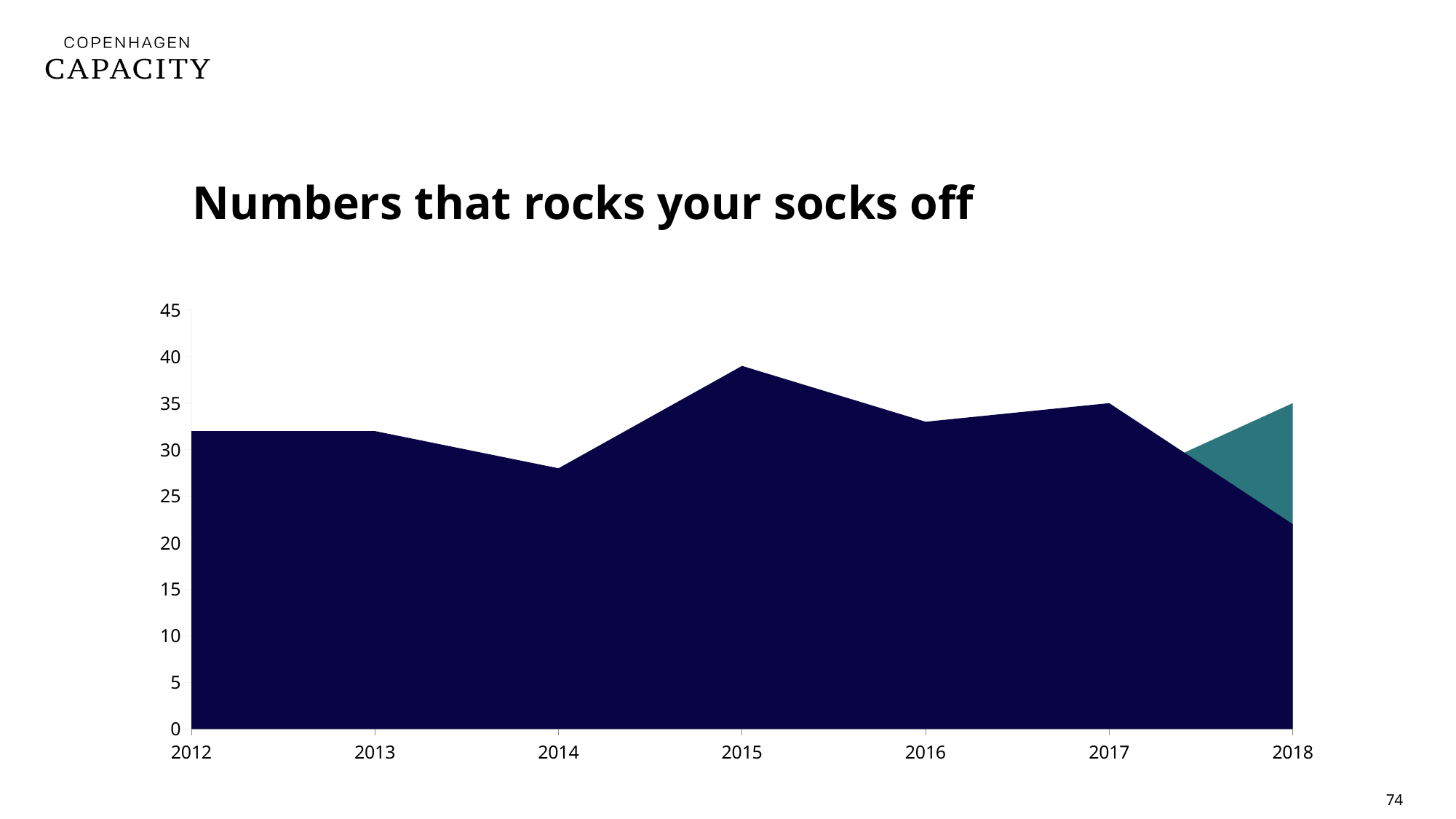
How many years are shown along the x axis of the chart? 7 Does the value rise or fall from 2014 to 2015? rise Does the dark navy area rise or fall from 2017 to 2018? fall Which is larger, the value for 2014 or the value for 2015? 2015 What kind of chart is shown on the slide? area chart Is the value for 2012 greater or less than 30? greater Which year has the highest value in the chart? 2015 Is the value of the dark navy area for 2018 greater or less than 25? less Which year has the lowest value for the dark navy area? 2018 What is the title of the chart on the slide? Numbers that rocks your socks off Is the value for 2014 greater or less than 30? less